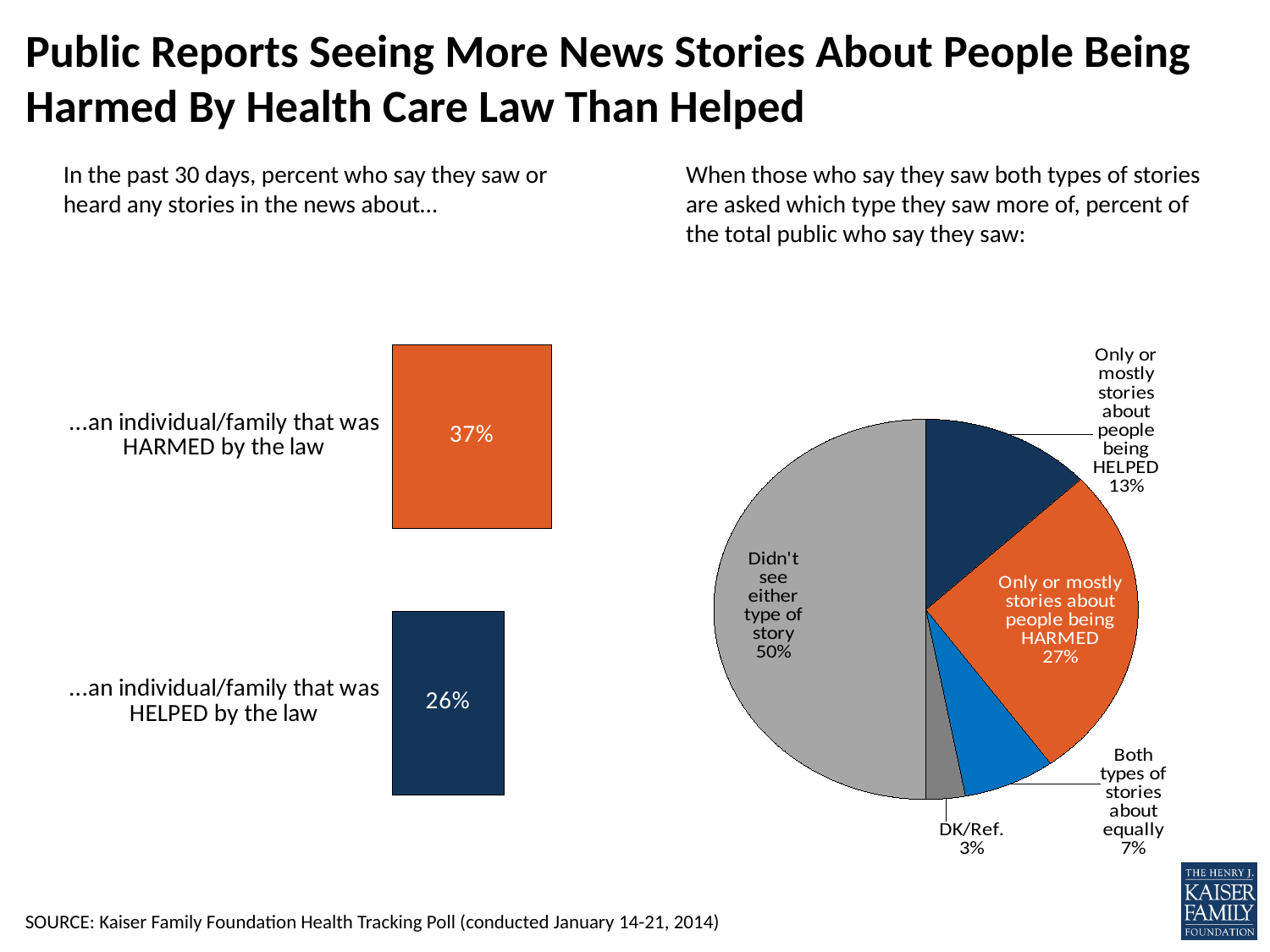
In the bar chart on the left, what is the difference between the HARMED and HELPED percentages? 11 percentage points How many slices does the pie chart on the right have? 5 In the pie chart on the right, which slice is the smallest? DK/Ref. In the pie chart on the right, what percent say they saw both types of stories about equally? 7% In the bar chart on the left, what percent say they saw or heard stories about an individual/family that was HARMED by the law? 37% In the pie chart on the right, what percent say they didn't see either type of story? 50% In the bar chart on the left, which category has the higher value, HARMED or HELPED? HARMED What kind of chart is on the left side of the slide? Bar chart In the pie chart on the right, what is the difference between the HARMED slice and the HELPED slice? 14 percentage points In the bar chart on the left, what percent say they saw or heard stories about an individual/family that was HELPED by the law? 26% What kind of chart is on the right side of the slide? Pie chart In the pie chart on the right, what percent say they saw only or mostly stories about people being HARMED? 27%